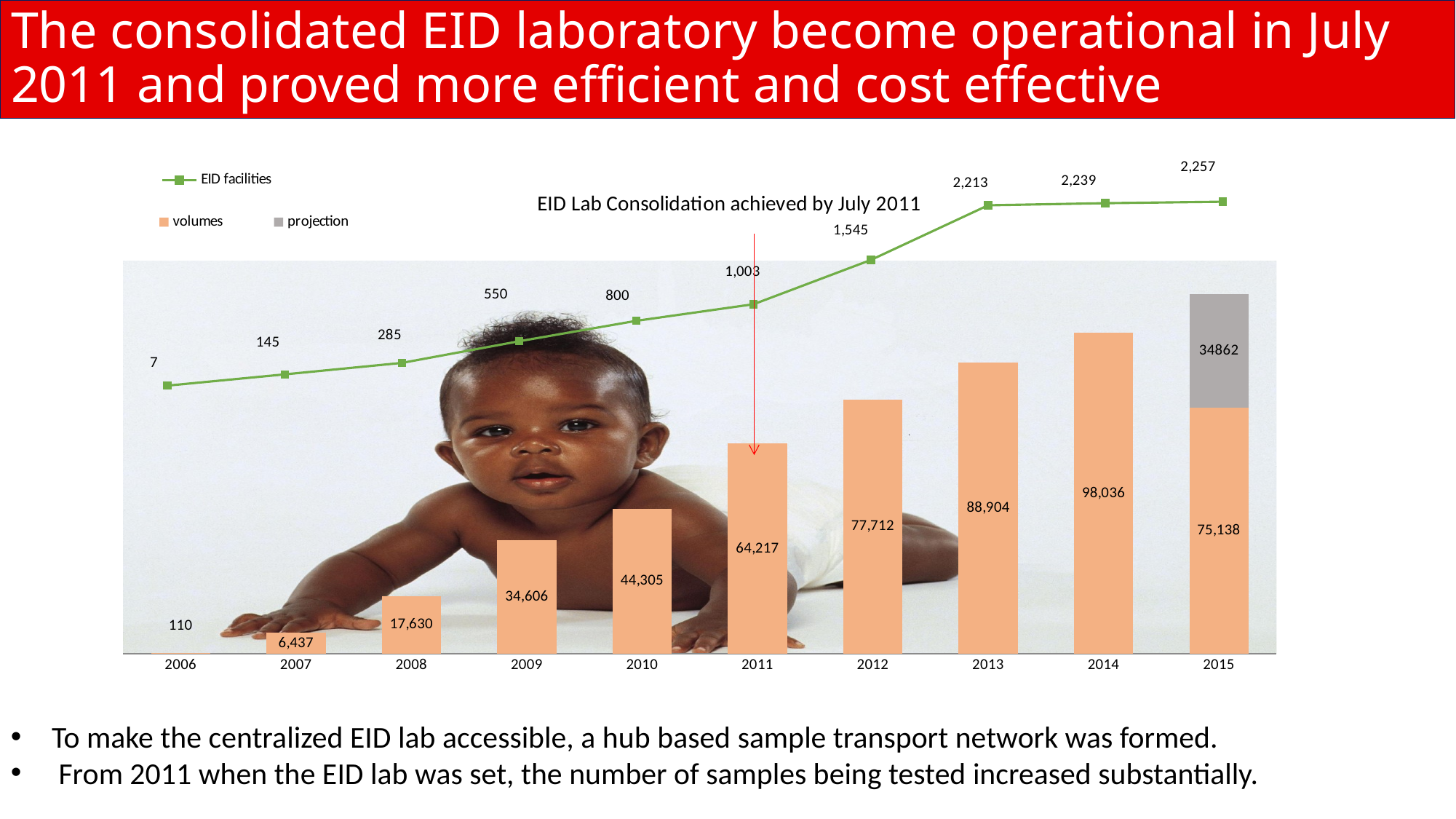
What is the projection value shown for 2015? 34862 Which series is shown as a green line with square markers? EID facilities Which year has the highest volumes value among the orange bars? 2014 How many series does the legend list? 3 Does the EID facilities line rise or fall from 2006 to 2015? rise Which is larger, the volumes value for 2011 or for 2010? 2011 Which year has the lowest EID facilities value? 2006 How many years are shown on the x axis? 10 What is the volumes value for 2013? 88,904 What is the total of the stacked bar for 2015 (volumes plus projection)? 110,000 What is the difference between the volumes for 2014 and 2013? 9,132 How many EID facilities are shown for 2011? 1,003